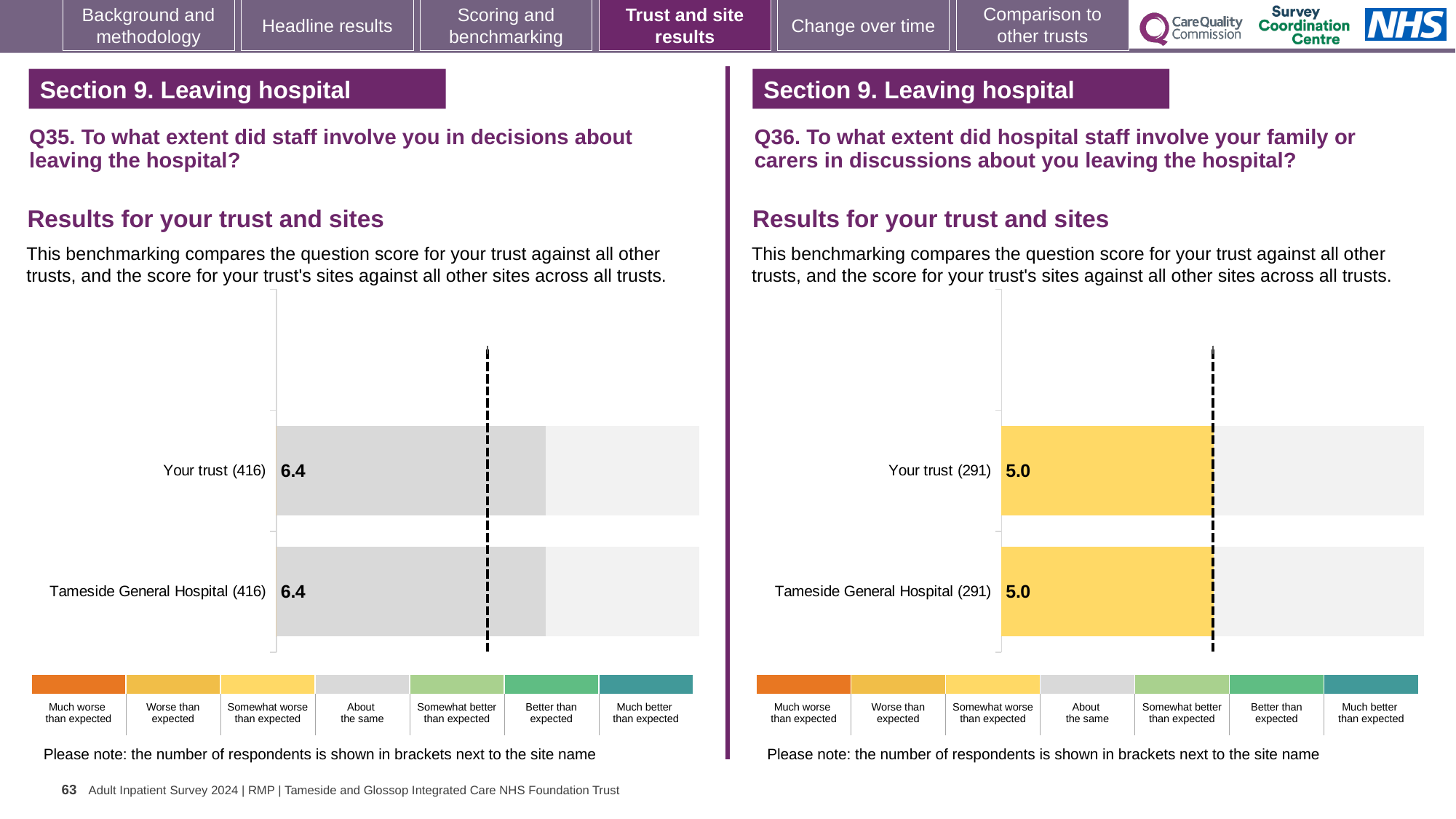
In the Q36 chart on the right, which benchmark category does the colour of the Your trust bar correspond to according to the legend? Somewhat worse than expected In the Q35 chart on the left, how many respondents are shown in brackets for Your trust? 416 In the Q35 chart on the left, what is the difference between the score for Your trust and the score for Tameside General Hospital? 0.0 In the Q36 chart on the right, what is the score for Tameside General Hospital? 5.0 In the Q36 chart on the right, what is the score for Your trust? 5.0 In the Q35 chart on the left, what is the score for Tameside General Hospital? 6.4 In the Q35 chart on the left, what is the score for Your trust? 6.4 In the Q36 chart on the right, what is the difference between the score for Your trust and the score for Tameside General Hospital? 0.0 What kind of chart is the Q35 chart on the left? Bar chart How many bars are plotted in the Q36 chart on the right? 2 In the Q36 chart on the right, how many respondents are shown in brackets for Tameside General Hospital? 291 How many bars are plotted in the Q35 chart on the left? 2